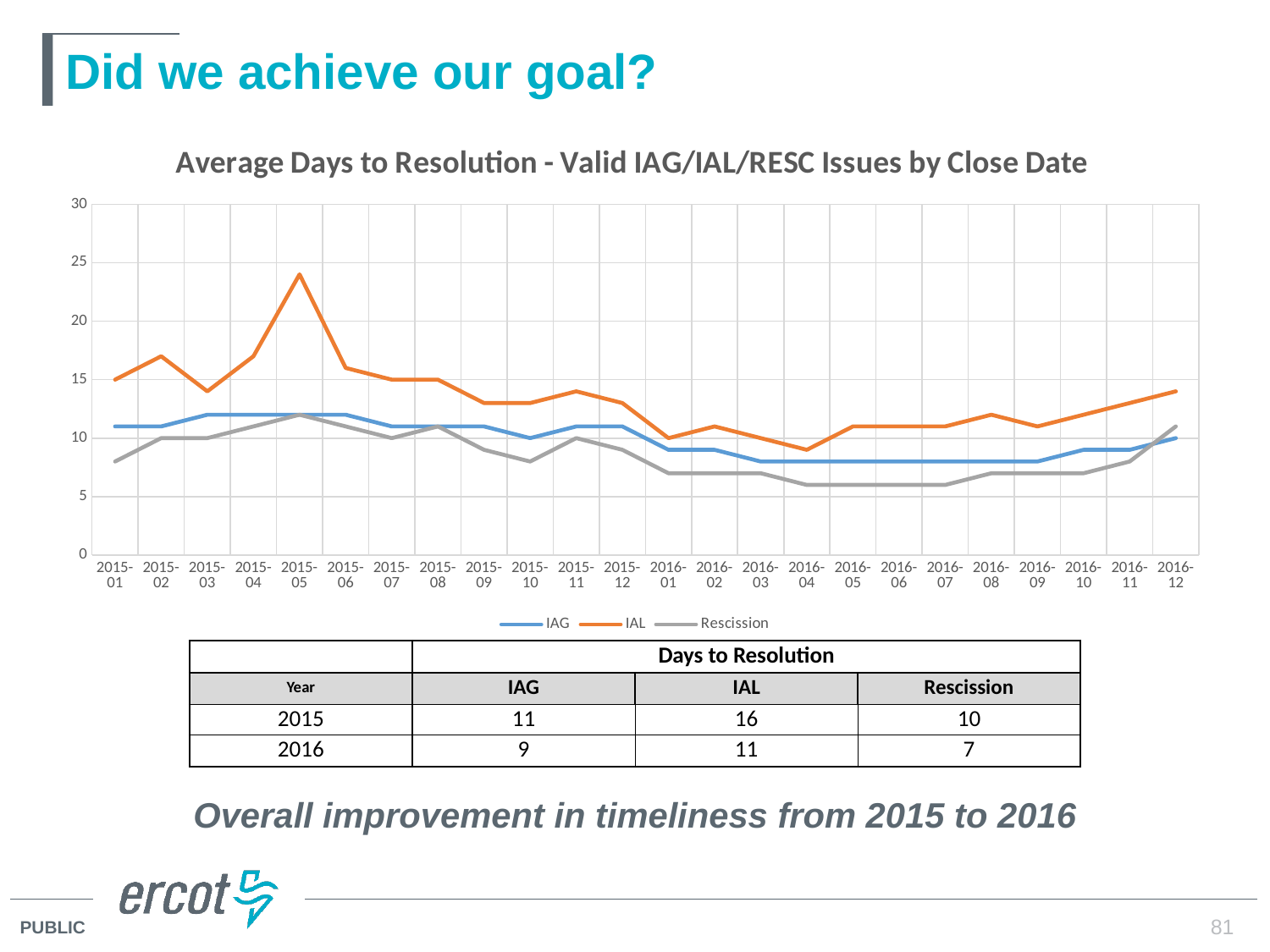
Which series is drawn in orange in the chart? IAL Which series has the highest value at 2015-05? IAL What kind of chart is shown on the slide? line chart Is the IAL value for 2015-05 greater or less than 20? greater Is the Rescission value for 2016-04 greater or less than 10? less How many series does the chart legend list? 3 In which month does the IAL series reach its highest value? 2015-05 Is the IAG value for 2015-03 greater or less than 10? greater What is the title of the chart? Average Days to Resolution - Valid IAG/IAL/RESC Issues by Close Date Does the IAL series rise or fall from 2015-05 to 2015-06? fall How many months are plotted along the x axis of the chart? 24 Which series has the lowest value at 2016-04? Rescission